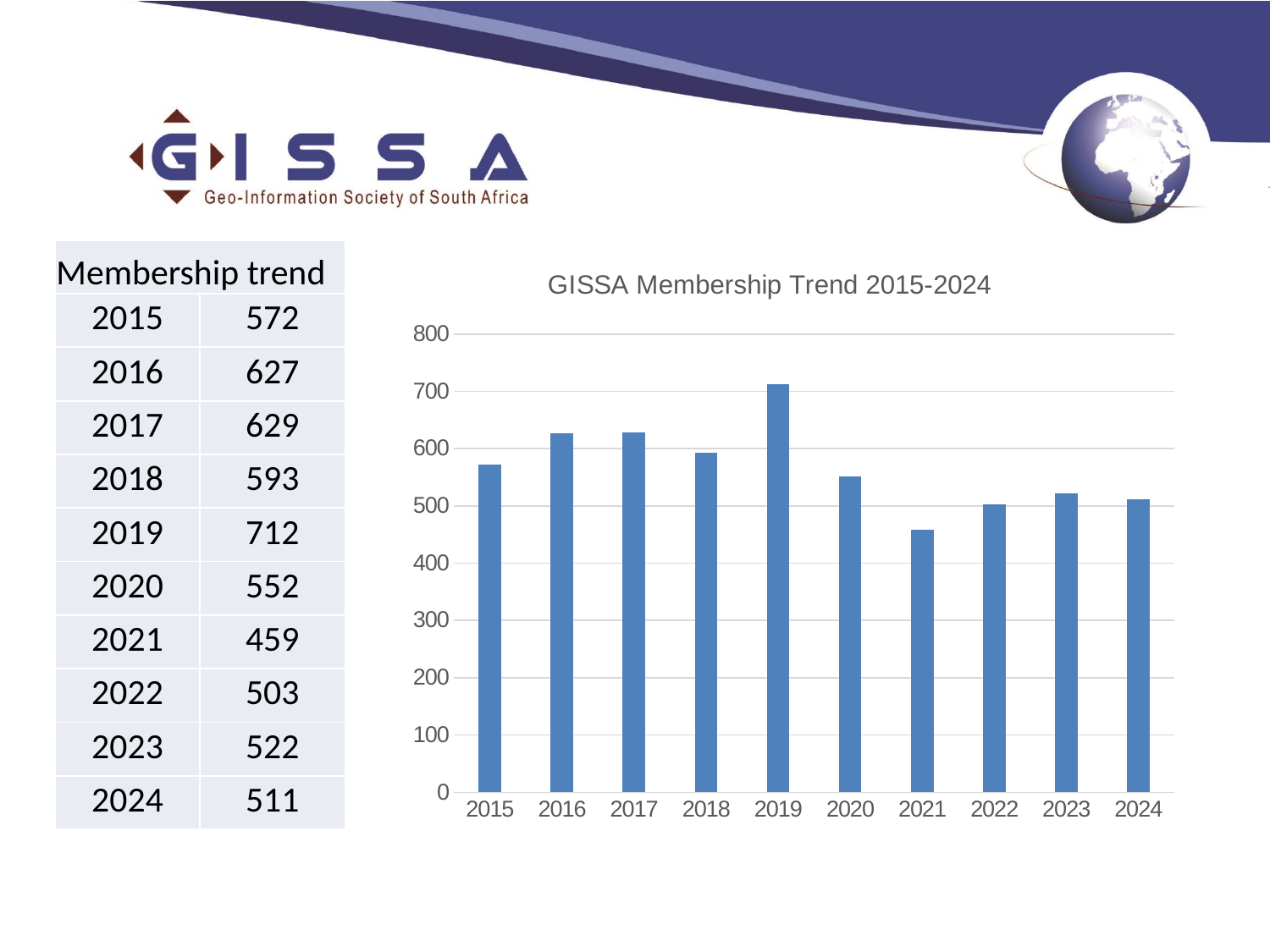
Is the membership value for 2020 greater or less than 600? less How many years are plotted in the GISSA Membership Trend chart? 10 What is the title of the chart? GISSA Membership Trend 2015-2024 Which year has the highest membership in the chart? 2019 What kind of chart is shown on the slide? bar chart Does membership rise or fall from 2019 to 2021? fall What is the membership value for 2024? 511 What is the difference in membership between 2019 and 2020? 160 What is the membership value for 2019? 712 Which year has the lowest membership in the chart? 2021 Which year has a larger membership, 2016 or 2018? 2016 What is the membership value for 2021? 459